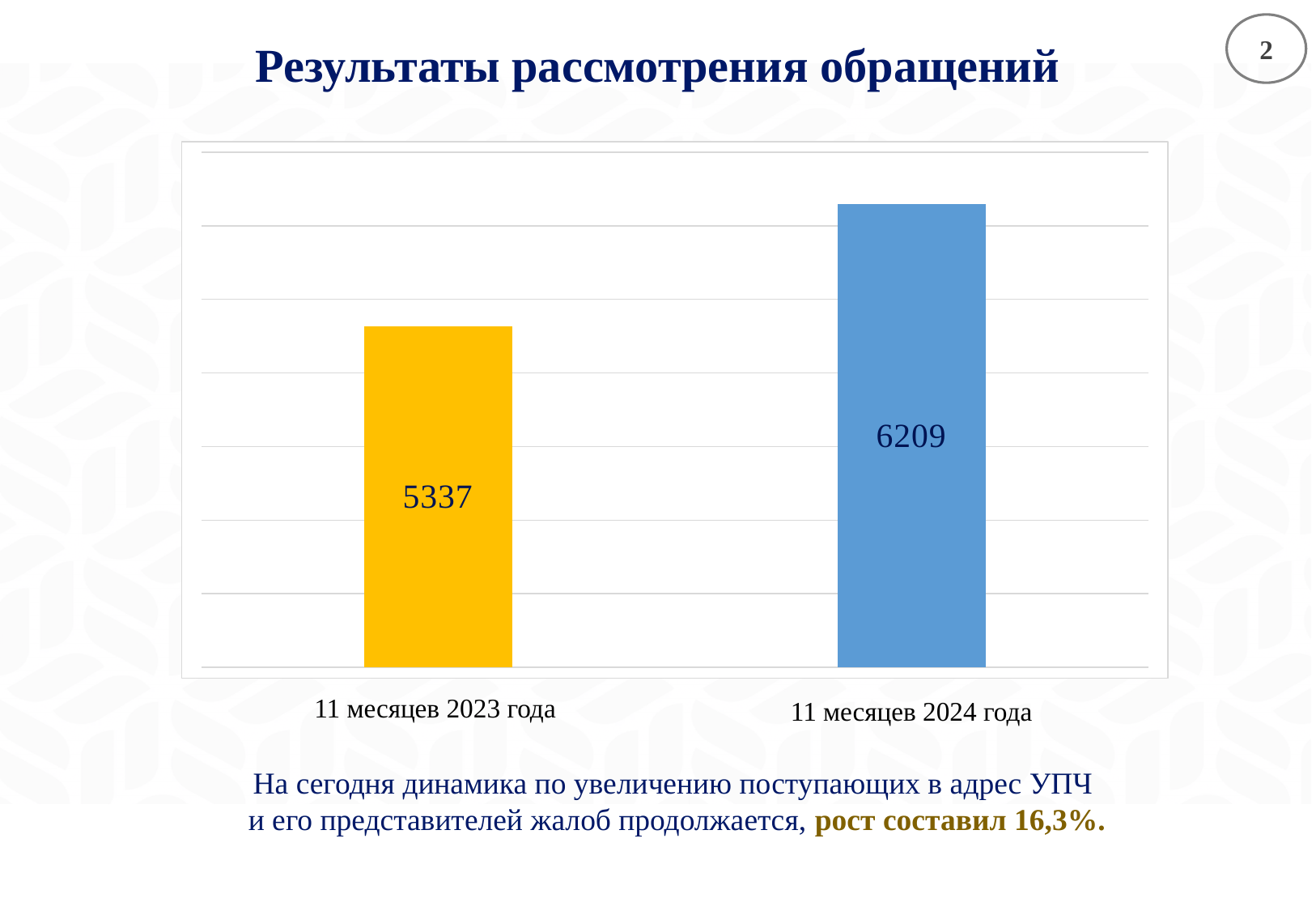
Which category has the highest value? 11 месяцев 2024 года What is the title of the slide containing the chart? Результаты рассмотрения обращений Which category has the lowest value? 11 месяцев 2023 года What kind of chart is shown on the slide? Bar chart What is the total of the two values shown in the chart? 11546 What is the difference between the values for 11 месяцев 2024 года and 11 месяцев 2023 года? 872 Which is larger: the value for 11 месяцев 2023 года or for 11 месяцев 2024 года? 11 месяцев 2024 года What is the value for 11 месяцев 2024 года? 6209 Do the values rise or fall from 11 месяцев 2023 года to 11 месяцев 2024 года? Rise What is the value for 11 месяцев 2023 года? 5337 What colour is the bar for 11 месяцев 2024 года? Blue How many categories are shown in the chart? 2